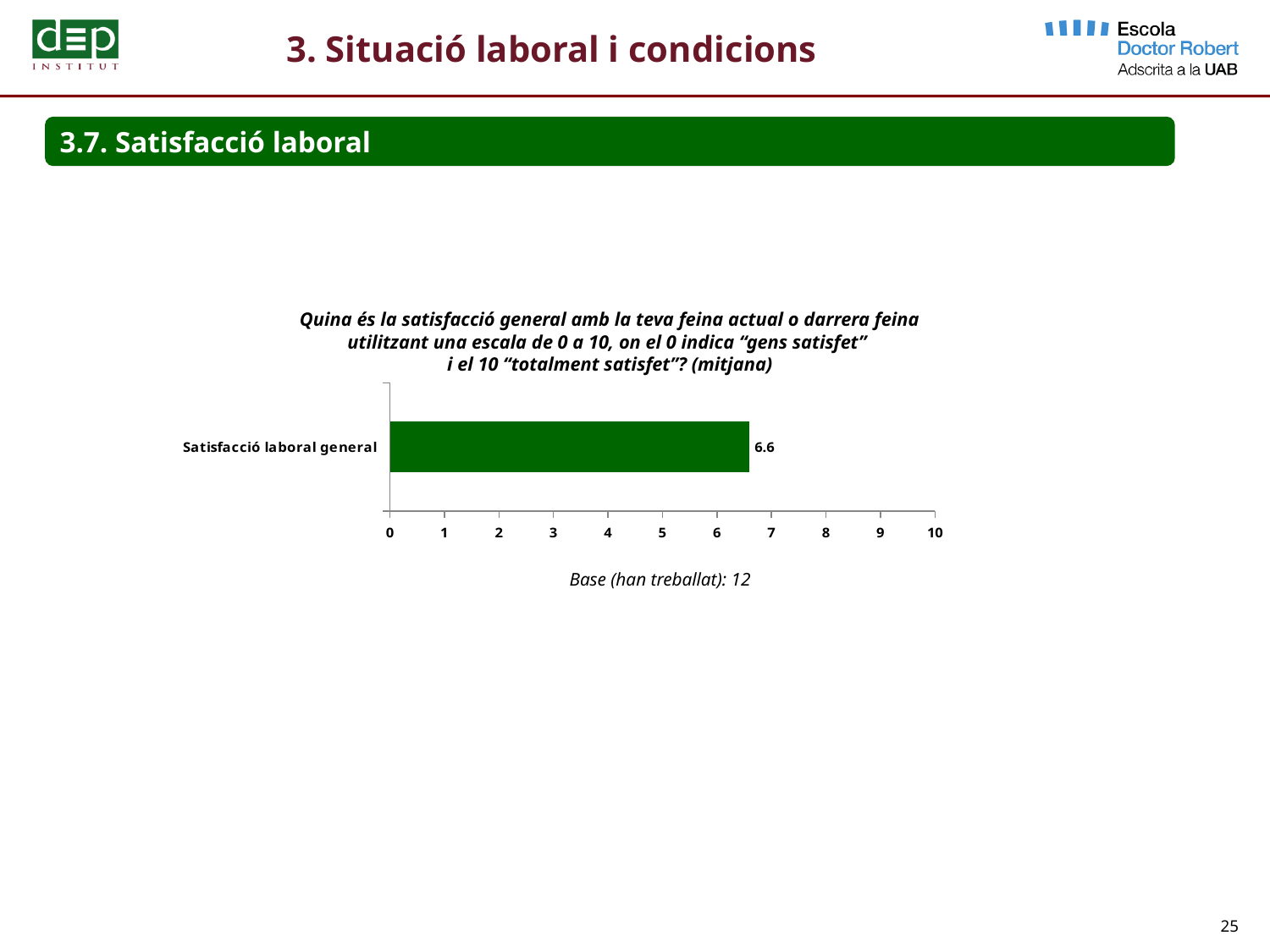
What is the maximum value shown on the horizontal axis of the chart? 10 How many categories are plotted in the chart? 1 Is the value for Satisfacció laboral general greater or less than 5? greater What is the value shown for Satisfacció laboral general? 6.6 What is the label of the single bar in the chart? Satisfacció laboral general What is the base (number of respondents) stated below the chart? 12 Is the value for Satisfacció laboral general greater or less than 7? less What kind of chart is shown on the slide? bar chart